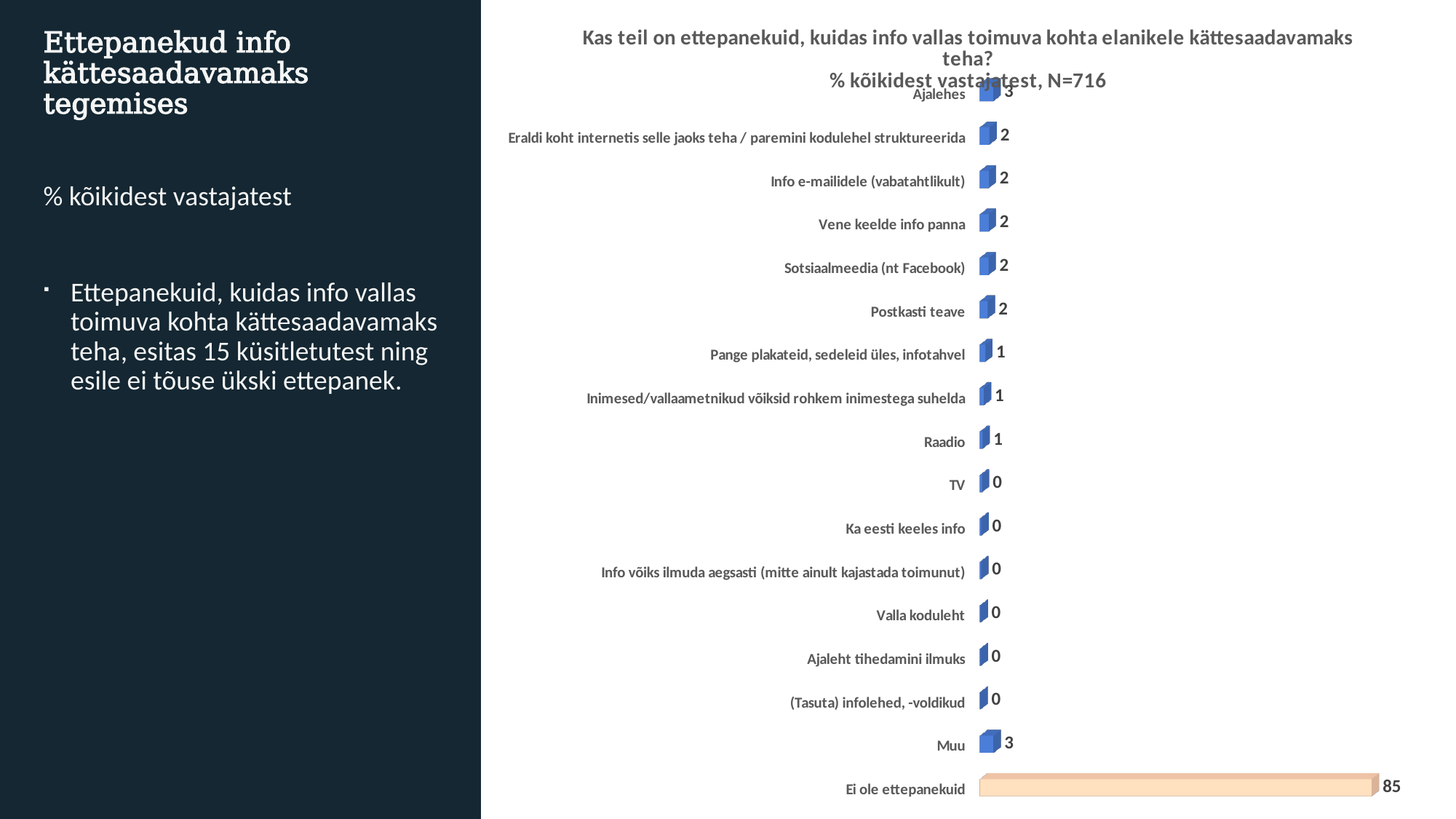
What is the value for "TV"? 0 What is the difference between the values for "Ei ole ettepanekuid" and "Muu"? 82 What kind of chart is shown on the slide? bar chart What sample size (N) is stated in the chart title? N=716 What is the value for "Raadio"? 1 What is the value for "Muu"? 3 What is the value for "Ajalehes"? 3 How many categories are shown in the chart? 17 What is the value for "Sotsiaalmeedia (nt Facebook)"? 2 Which category has the highest value? Ei ole ettepanekuid Which is larger, the value for "Ajalehes" or the value for "Raadio"? Ajalehes What is the value for "Ei ole ettepanekuid"? 85